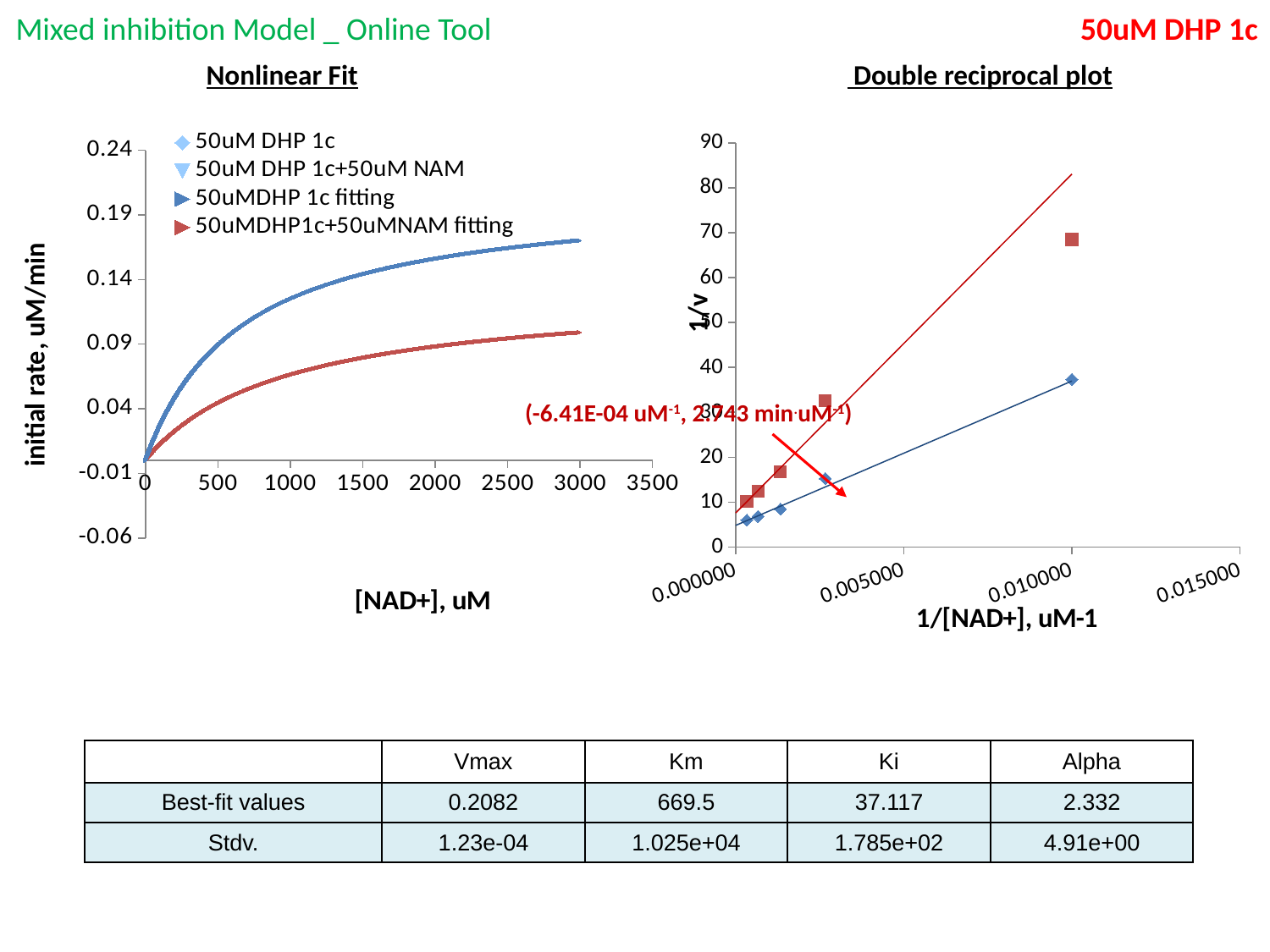
What is the highest tick value shown on the x axis of the Nonlinear Fit chart? 3500 In the Nonlinear Fit chart, which fitting curve reaches a higher initial rate at [NAD+] = 3000 uM? 50uMDHP 1c fitting In the Double reciprocal plot, do the 1/v values rise or fall as 1/[NAD+] increases? rise In the Nonlinear Fit chart, does the 50uMDHP 1c fitting curve rise or fall as [NAD+] increases? rise In the Double reciprocal plot, which series has the steeper fitted line, the red squares or the blue diamonds? red squares In the Nonlinear Fit chart, at [NAD+] = 3000 uM, is the 50uMDHP 1c fitting curve greater or less than 0.14 uM/min? greater In the Nonlinear Fit chart, at [NAD+] = 3000 uM, is the 50uMDHP1c+50uMNAM fitting curve greater or less than 0.14 uM/min? less In the Nonlinear Fit chart, how many series does the legend list? 4 In the Nonlinear Fit chart, what is the label of the last legend entry? 50uMDHP1c+50uMNAM fitting In the Double reciprocal plot, is the 1/v value of the red square point near 1/[NAD+] = 0.010000 greater or less than 60? greater What kind of chart is the Double reciprocal plot? scatter chart